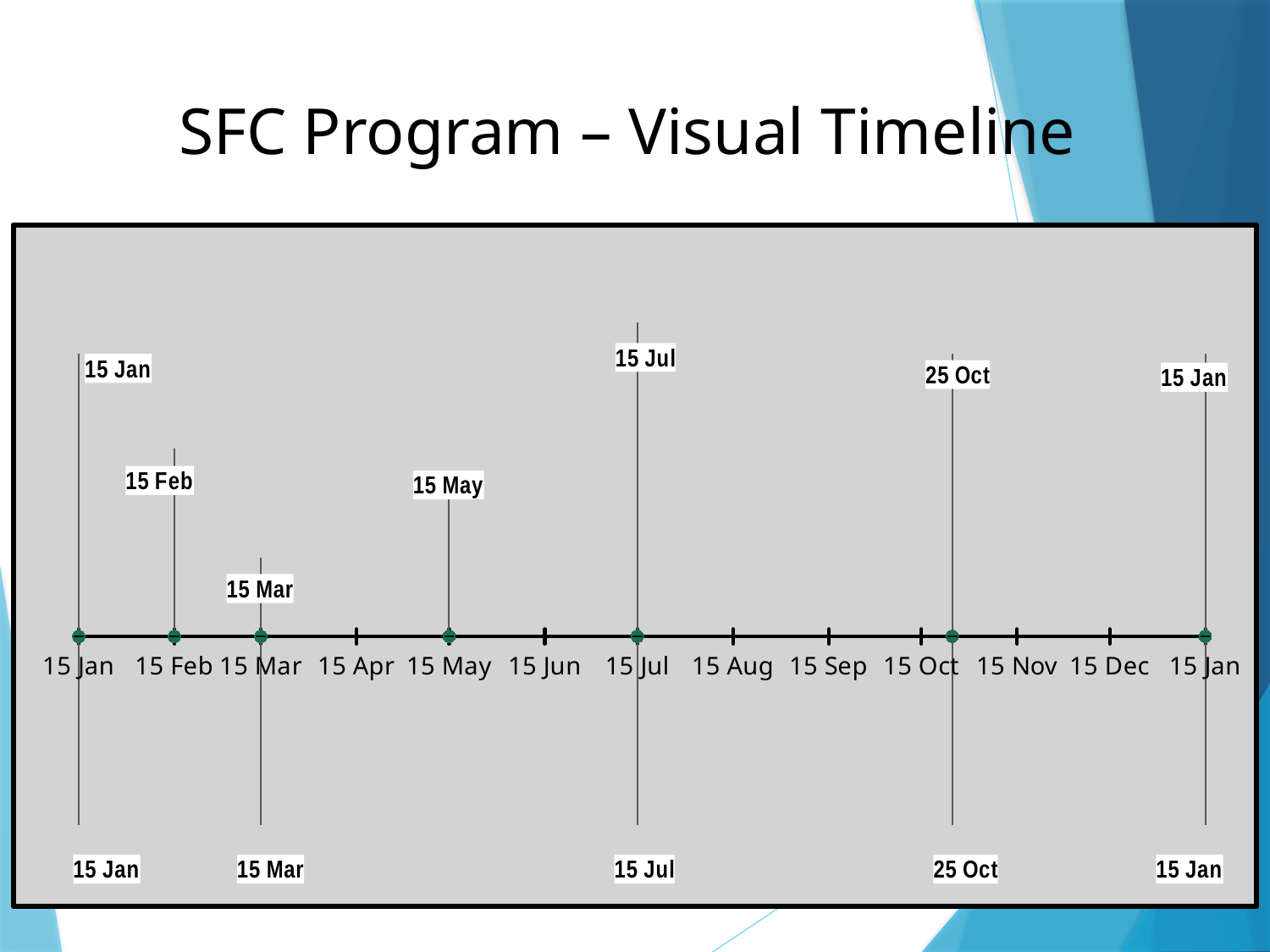
How many event markers are plotted on the timeline? 7 What is the date label of the first event marker on the timeline? 15 Jan How many date labels are shown above the horizontal axis of the timeline? 7 How many tick marks are on the horizontal axis of the timeline? 13 Which event marker has the tallest line above the axis? 15 Jul What is the date label of the event marker that falls between 15 Mar and 15 Jul? 15 May What is the label of the first tick on the horizontal axis? 15 Jan Which event label on the timeline is not on the 15th of a month? 25 Oct Which event marker has the shortest line above the axis? 15 Mar What is the date label of the last event marker on the timeline? 15 Jan What is the title of the chart on the slide? SFC Program – Visual Timeline